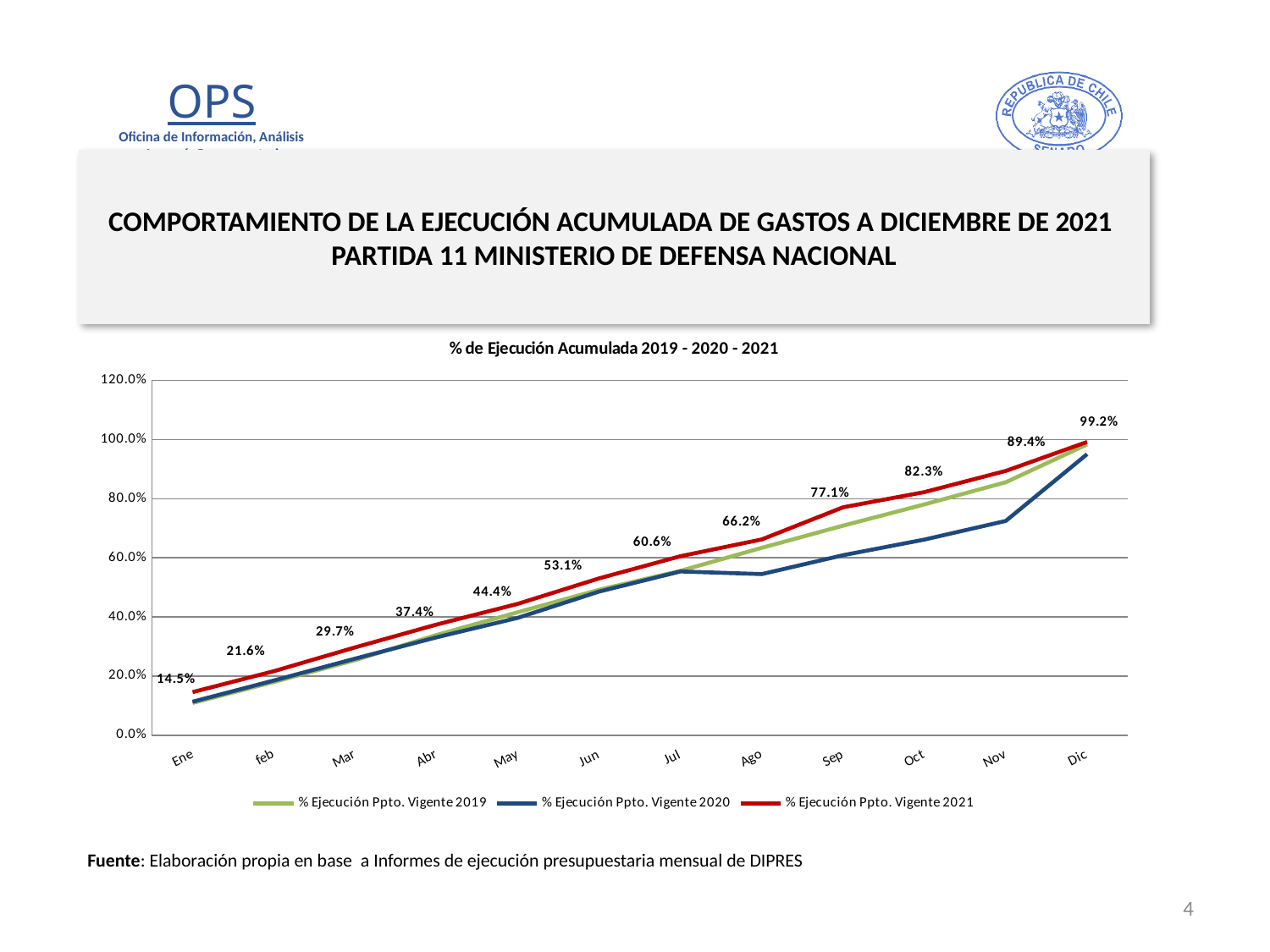
Does the % Ejecución Ppto. Vigente 2021 series rise or fall from Ene to Dic? rise What is the value for % Ejecución Ppto. Vigente 2021 in Dic? 99.2% What is the title of the chart? % de Ejecución Acumulada 2019 - 2020 - 2021 Is the value for % Ejecución Ppto. Vigente 2020 in Ago greater or less than 60.0%? less What kind of chart is shown on the slide? line chart In which month is the % Ejecución Ppto. Vigente 2021 value highest? Dic How many series does the legend list? 3 What is the value for % Ejecución Ppto. Vigente 2021 in Jun? 53.1% What is the value for % Ejecución Ppto. Vigente 2021 in Ene? 14.5% In Sep, which is larger: % Ejecución Ppto. Vigente 2021 or % Ejecución Ppto. Vigente 2020? % Ejecución Ppto. Vigente 2021 What is the difference between the % Ejecución Ppto. Vigente 2021 values for Dic and Nov? 9.8% How many months are shown on the x axis? 12